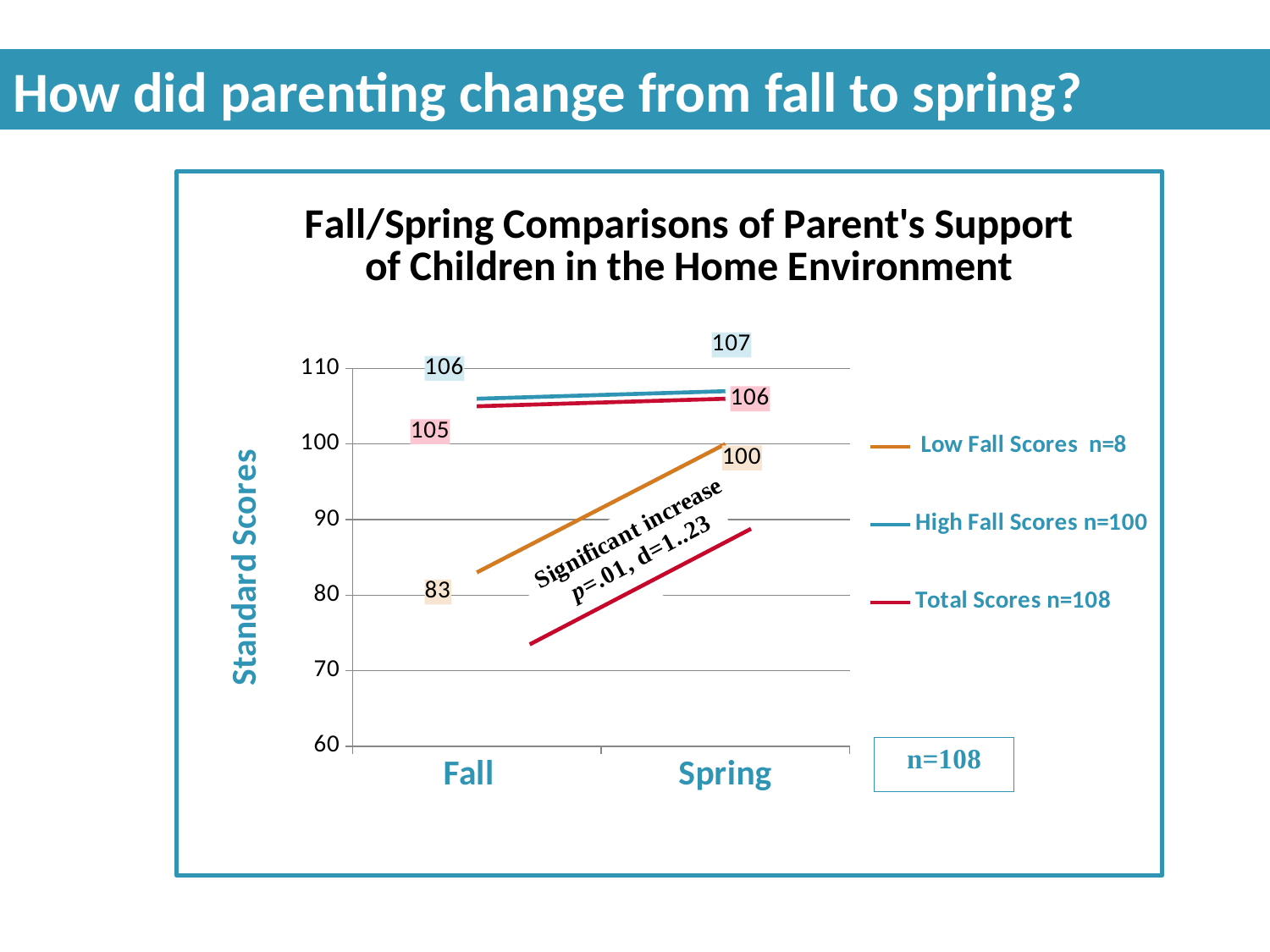
Which series has the highest value in Spring? High Fall Scores n=100 What is the Low Fall Scores value in Spring? 100 Do the Low Fall Scores rise or fall from Fall to Spring? rise What is the Low Fall Scores value in Fall? 83 What is the difference between the High Fall Scores and Low Fall Scores values in Fall? 23 What is the Total Scores value in Fall? 105 What is the label of the vertical axis? Standard Scores What is the High Fall Scores value in Spring? 107 Which series has the lowest value in Fall? Low Fall Scores n=8 By how much did the Low Fall Scores increase from Fall to Spring? 17 What kind of chart is shown on the slide? line chart How many series does the legend list? 3